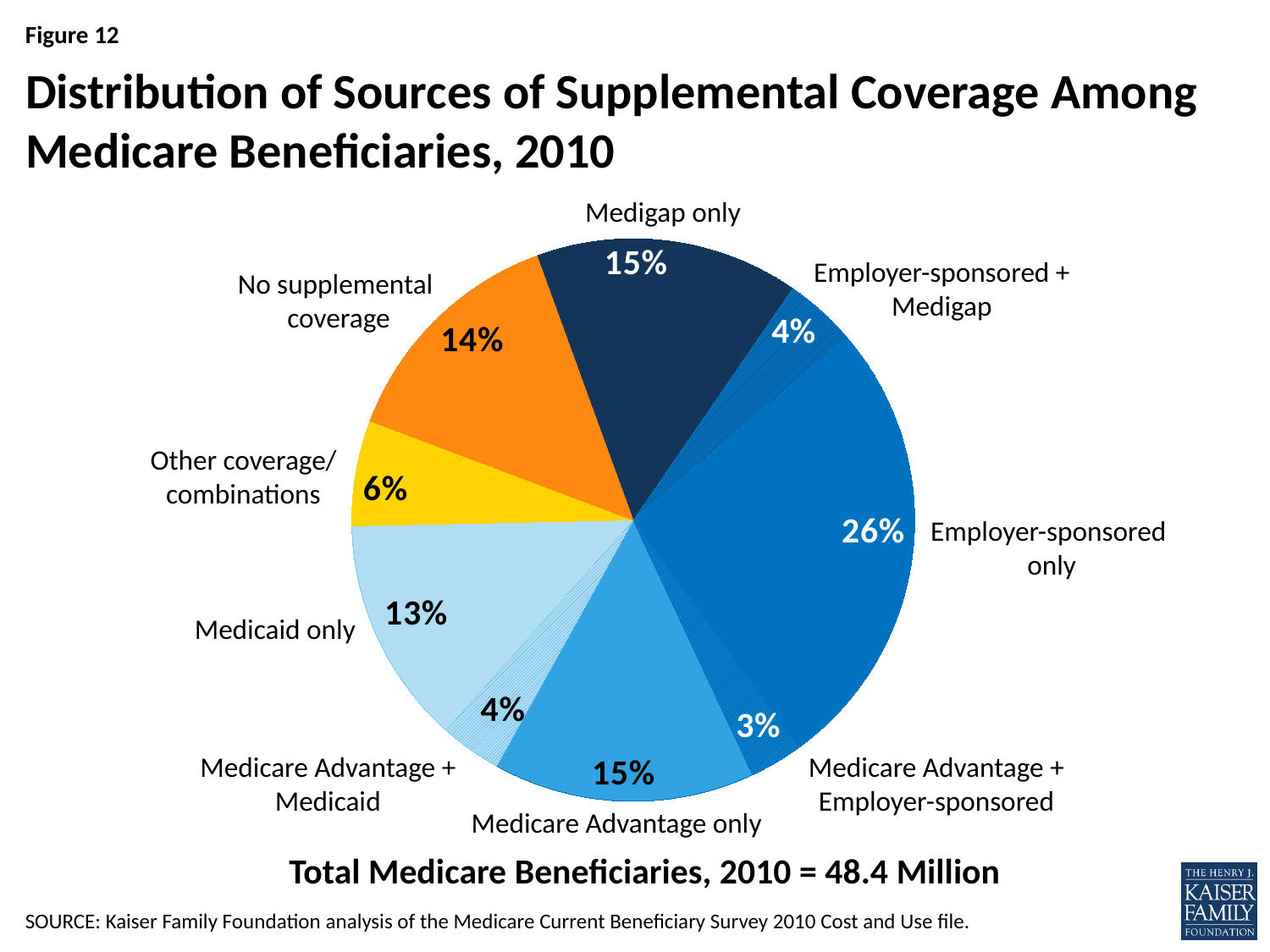
What share of Medicare beneficiaries had Medicare Advantage + Employer-sponsored coverage? 3% What is the title of the chart? Distribution of Sources of Supplemental Coverage Among Medicare Beneficiaries, 2010 Which source of supplemental coverage has the largest share of the pie? Employer-sponsored only What share of Medicare beneficiaries had no supplemental coverage? 14% What kind of chart is shown on the slide? pie chart Which source of supplemental coverage has the smallest share of the pie? Medicare Advantage + Employer-sponsored What is the difference in percentage points between Employer-sponsored only and Medigap only? 11 How many slices does the pie chart have? 9 What share of Medicare beneficiaries had employer-sponsored coverage only? 26% What share of Medicare beneficiaries had Medicaid only? 13% Which is larger, the share for Medicaid only or the share for Other coverage/combinations? Medicaid only What is the total number of Medicare beneficiaries in 2010 stated below the chart? 48.4 Million